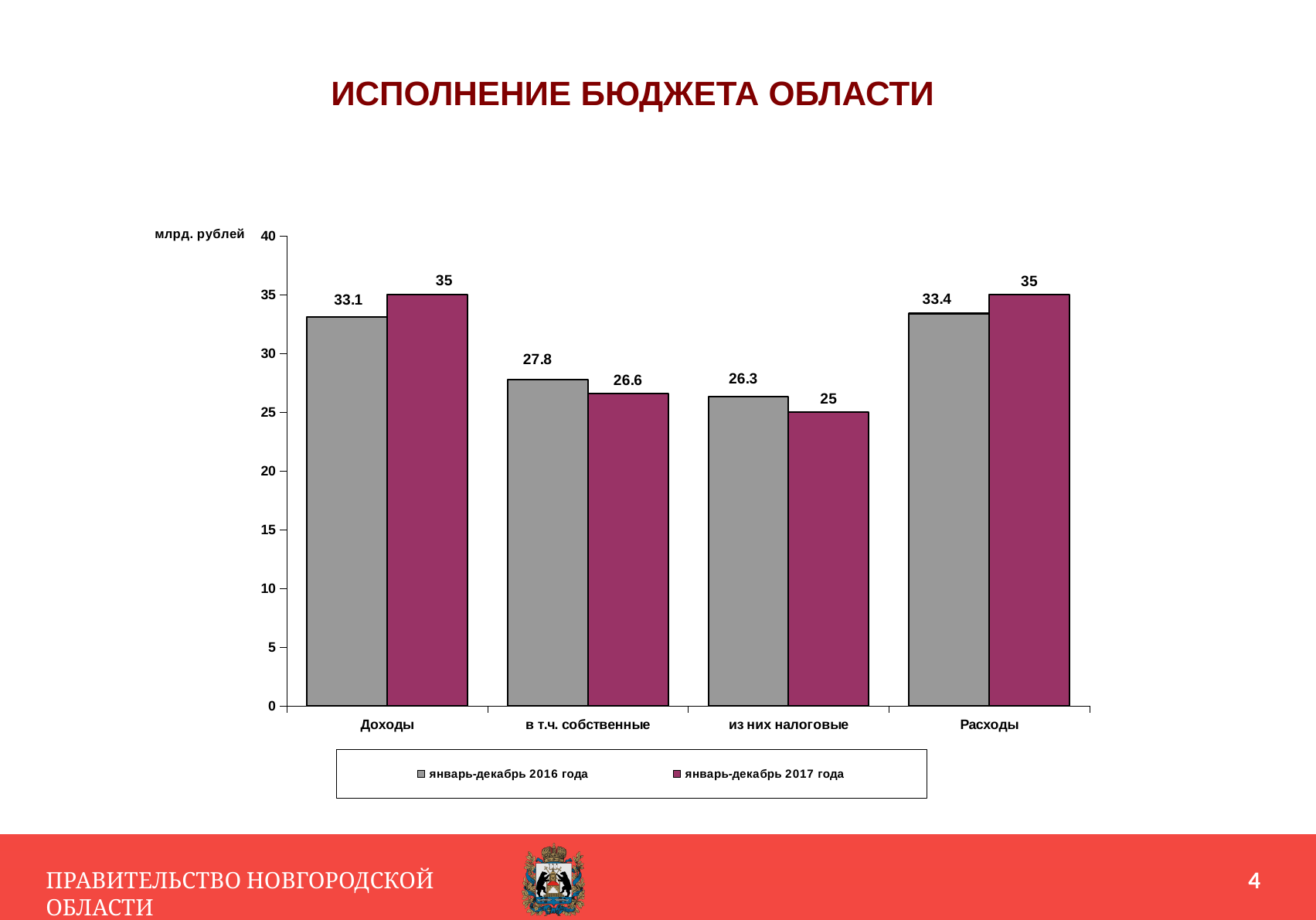
Which category has the lowest value in the январь-декабрь 2017 года series? из них налоговые How many categories are shown on the x axis? 4 What is the difference between the 2016 and 2017 values for в т.ч. собственные? 1.2 What is the value for в т.ч. собственные in январь-декабрь 2016 года? 27.8 Which is larger for из них налоговые: the январь-декабрь 2016 года value or the январь-декабрь 2017 года value? январь-декабрь 2016 года What is the difference between the 2017 and 2016 values for Доходы? 1.9 What is the value for Доходы in январь-декабрь 2017 года? 35 What is the value for Расходы in январь-декабрь 2016 года? 33.4 What kind of chart is shown on the slide? bar chart What unit is shown on the y axis of the chart? млрд. рублей What is the value for из них налоговые in январь-декабрь 2017 года? 25 How many series does the legend list? 2